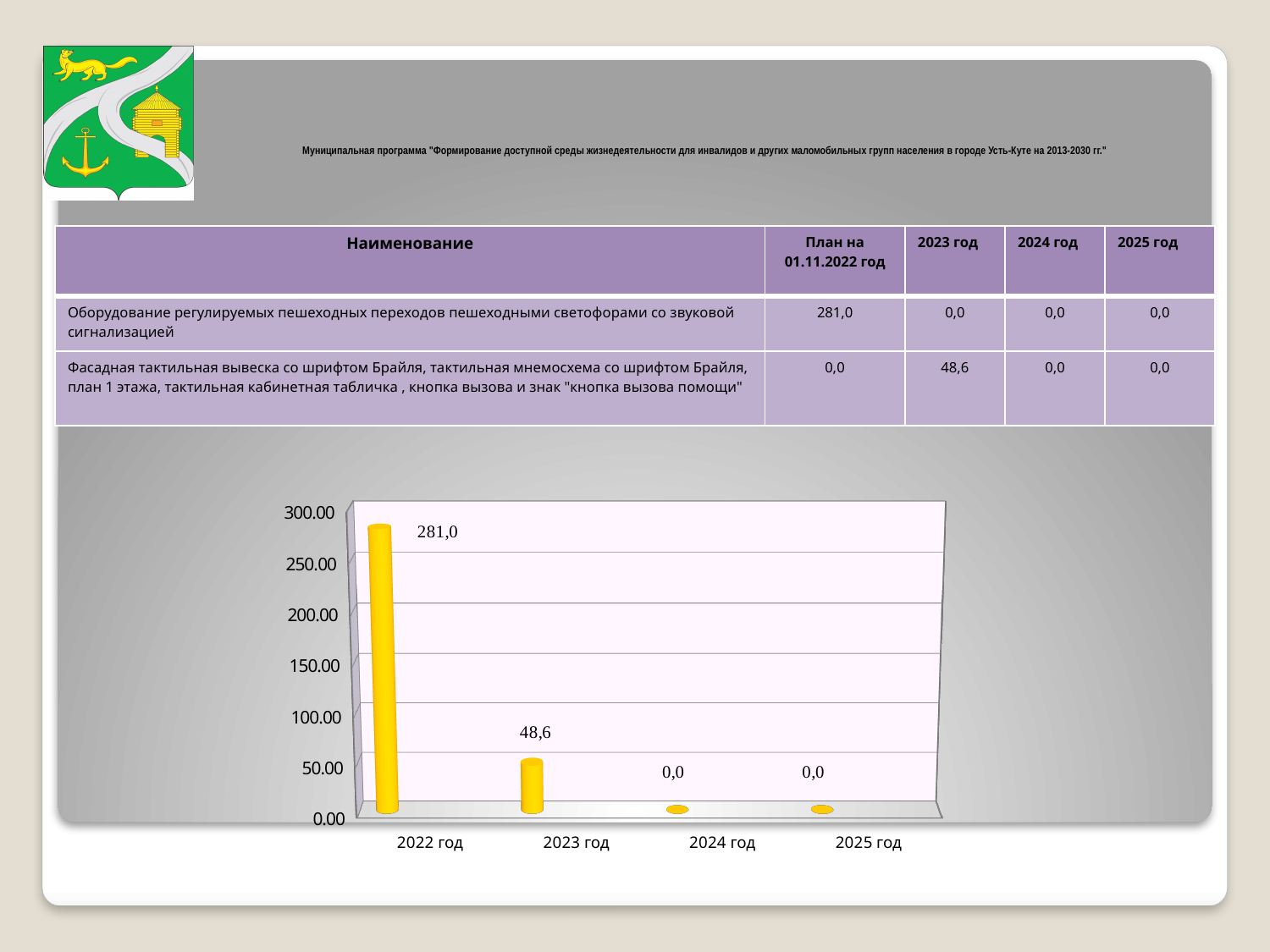
Do the values rise or fall from 2022 год to 2024 год? fall Is the value for 2022 год greater or less than 250.00? greater What is the difference between the values for 2022 год and 2023 год? 232,4 What is the value shown for 2023 год on the chart? 48,6 What is the value shown for 2025 год on the chart? 0,0 Is the value for 2023 год greater or less than 100.00? less What kind of chart is shown on the slide? bar chart Which year has the highest value on the chart? 2022 год What is the value shown for 2024 год on the chart? 0,0 What is the value shown for 2022 год on the chart? 281,0 Which is larger, the value for 2022 год or the value for 2023 год? 2022 год How many categories are shown on the x axis of the chart? 4